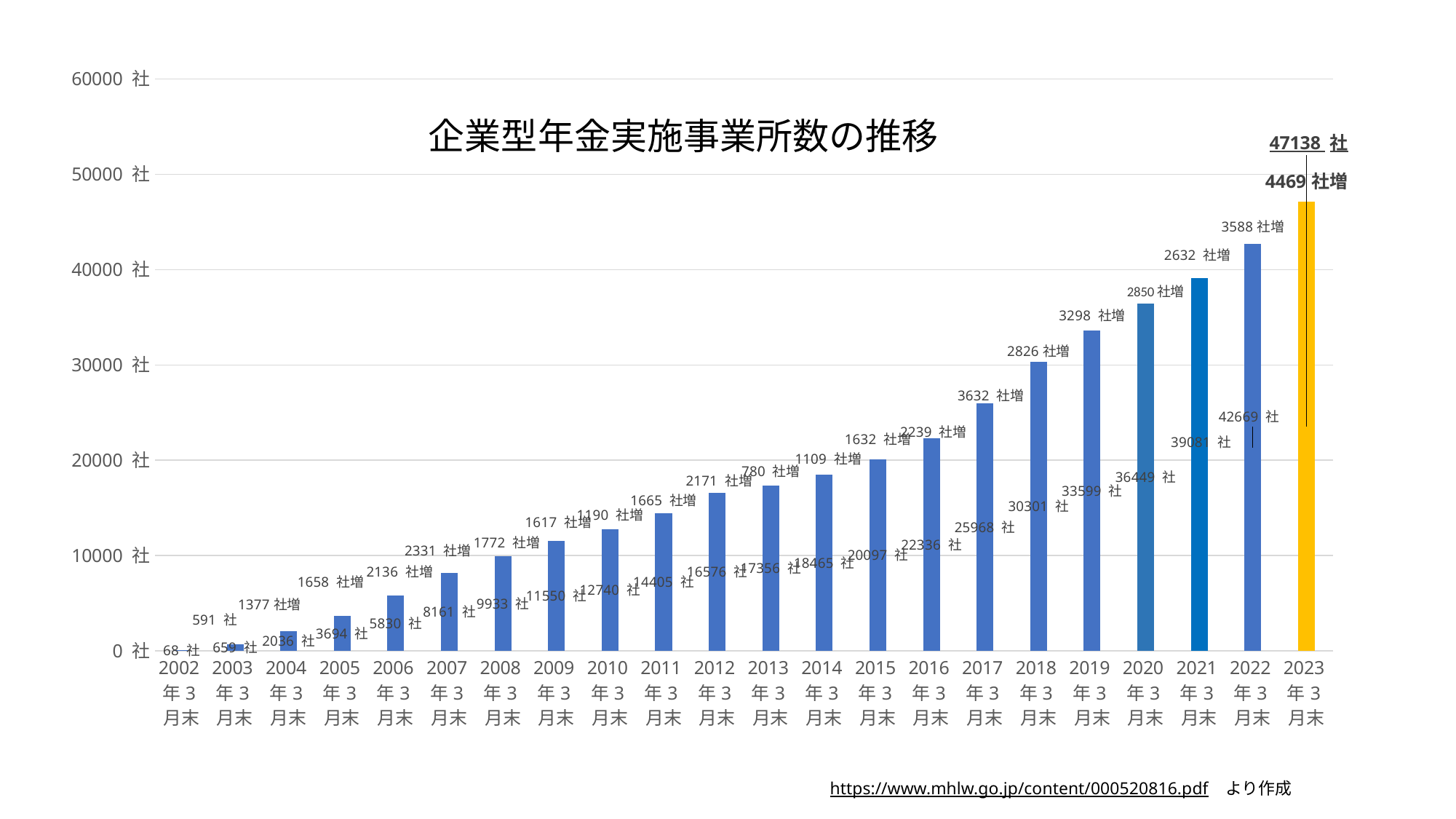
What is the title of the chart? 企業型年金実施事業所数の推移 Which year has the highest value? 2023年3月末 What is the value for 2023年3月末? 47138 社 Which year has the lowest value? 2002年3月末 What is the difference between the values for 2022年3月末 and 2021年3月末? 3588 社 How many bars (years) are plotted in the chart? 22 What kind of chart is shown on the slide? bar chart What is the increase labelled for 2023年3月末? 4469 社増 Do the values rise or fall from 2002 to 2023? rise What is the value for 2012年3月末? 16576 社 What is the value for 2002年3月末? 68 社 Is the value for 2018年3月末 greater or less than 30000 社? greater